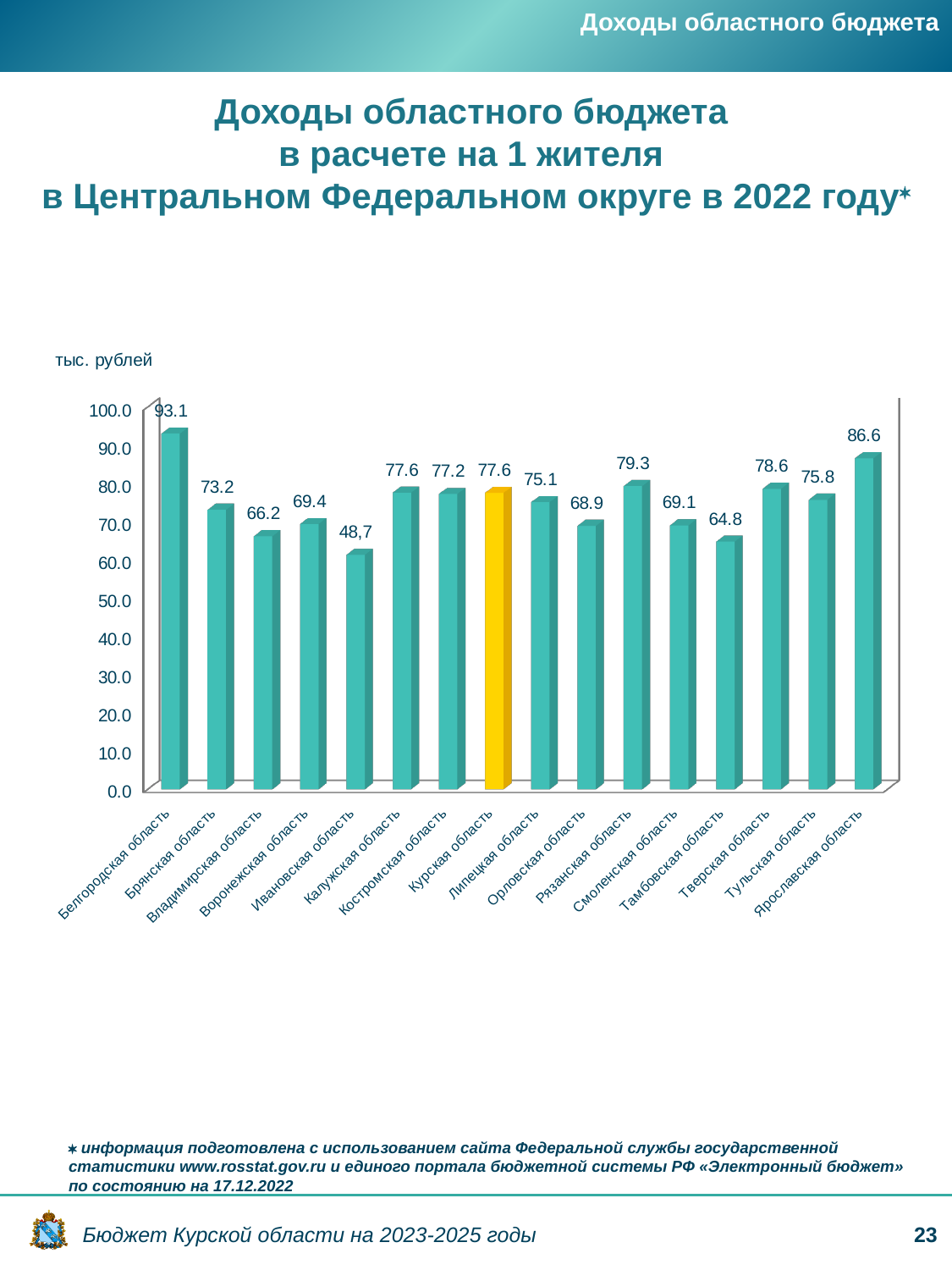
Which region has the highest value? Белгородская область Which region has the lowest value? Ивановская область Which is larger, the value for Рязанская область or the value for Тверская область? Рязанская область What unit is indicated above the chart's vertical axis? тыс. рублей Which region's bar is highlighted in yellow? Курская область What is the value for Тамбовская область? 64.8 What is the value for Курская область? 77.6 Is the value for Владимирская область greater or less than 70.0? less What kind of chart is shown on the slide? bar chart What is the difference between the values for Белгородская область and Ярославская область? 6.5 What is the value for Ярославская область? 86.6 How many regions are shown in the chart? 16